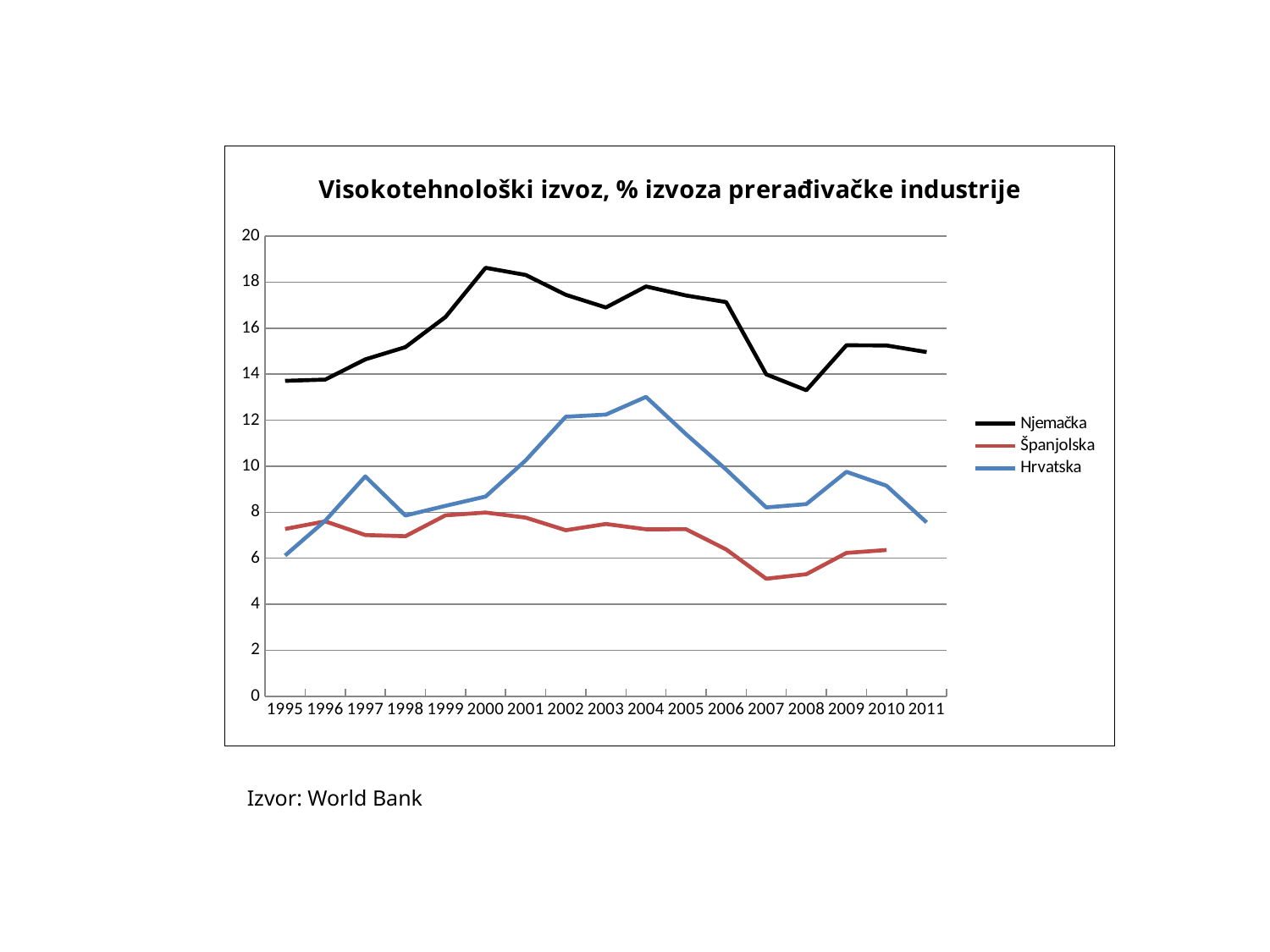
How many years are shown on the x axis? 17 Does the Hrvatska line rise or fall between 2004 and 2007? Fall Which series has the highest values throughout the chart? Njemačka Is the value for Španjolska in 2007 greater or less than 6? less Is the value for Hrvatska in 2004 greater or less than 12? greater What is the title of the chart? Visokotehnološki izvoz, % izvoza prerađivačke industrije Is the value for Njemačka in 2000 greater or less than 18? greater In 1995, which is larger: the value for Hrvatska or the value for Španjolska? Španjolska In which year does the Španjolska line reach its lowest value? 2007 In which year does the Hrvatska line reach its highest value? 2004 How many series does the legend list? 3 What kind of chart is shown on the slide? Line chart